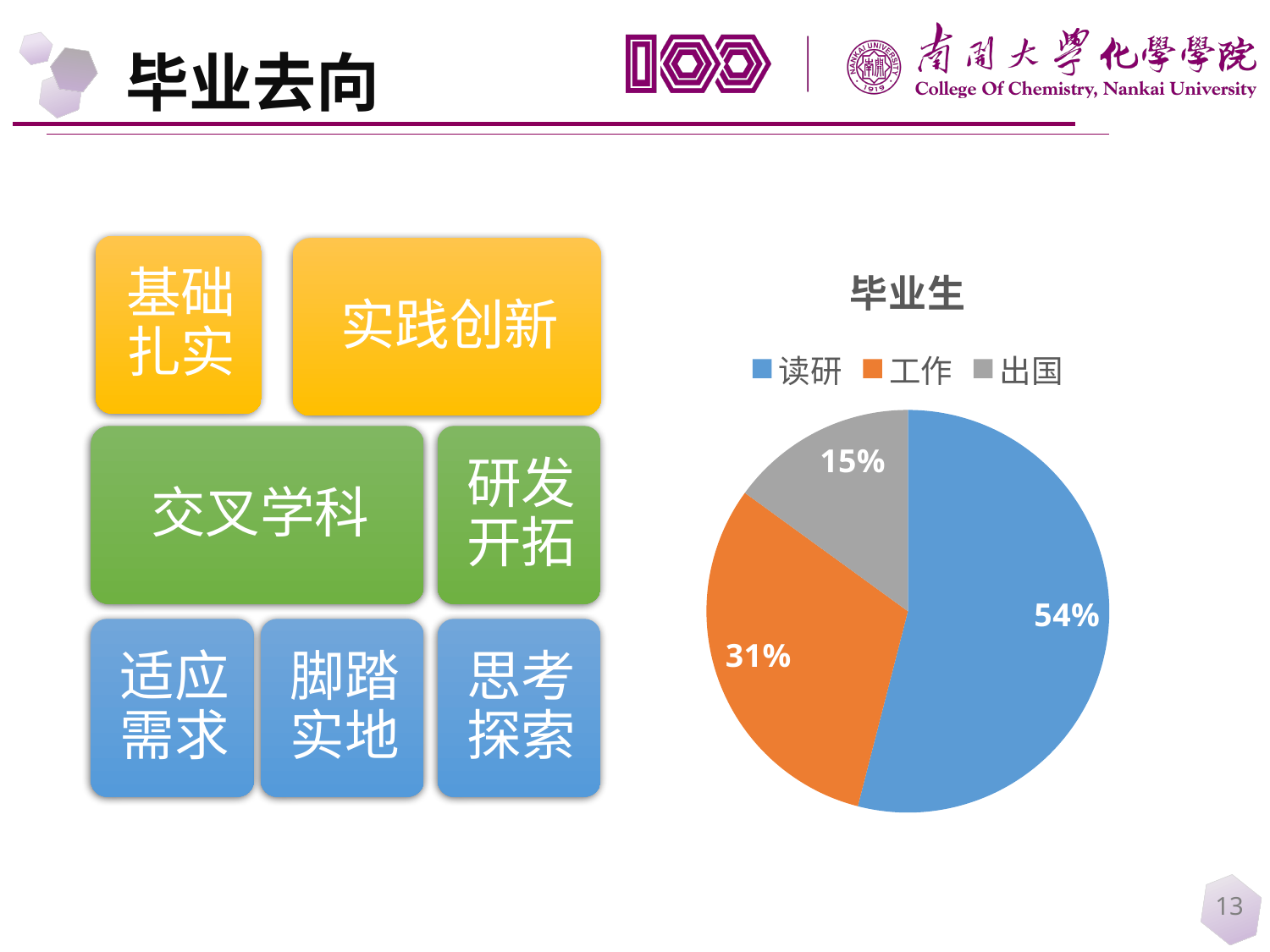
How many entries does the legend list? 3 Which is larger, the share for 工作 or the share for 出国? 工作 What type of chart is shown on the slide? pie chart What share of the pie does 工作 represent? 31% What share of the pie does 读研 represent? 54% What share of the pie does 出国 represent? 15% Which category has the smallest share of the pie? 出国 What colour is the 出国 slice in the pie chart? grey How many categories does the pie chart show? 3 What is the difference in percentage points between 读研 and 工作? 23% Which category has the largest share of the pie? 读研 What is the title of the pie chart? 毕业生